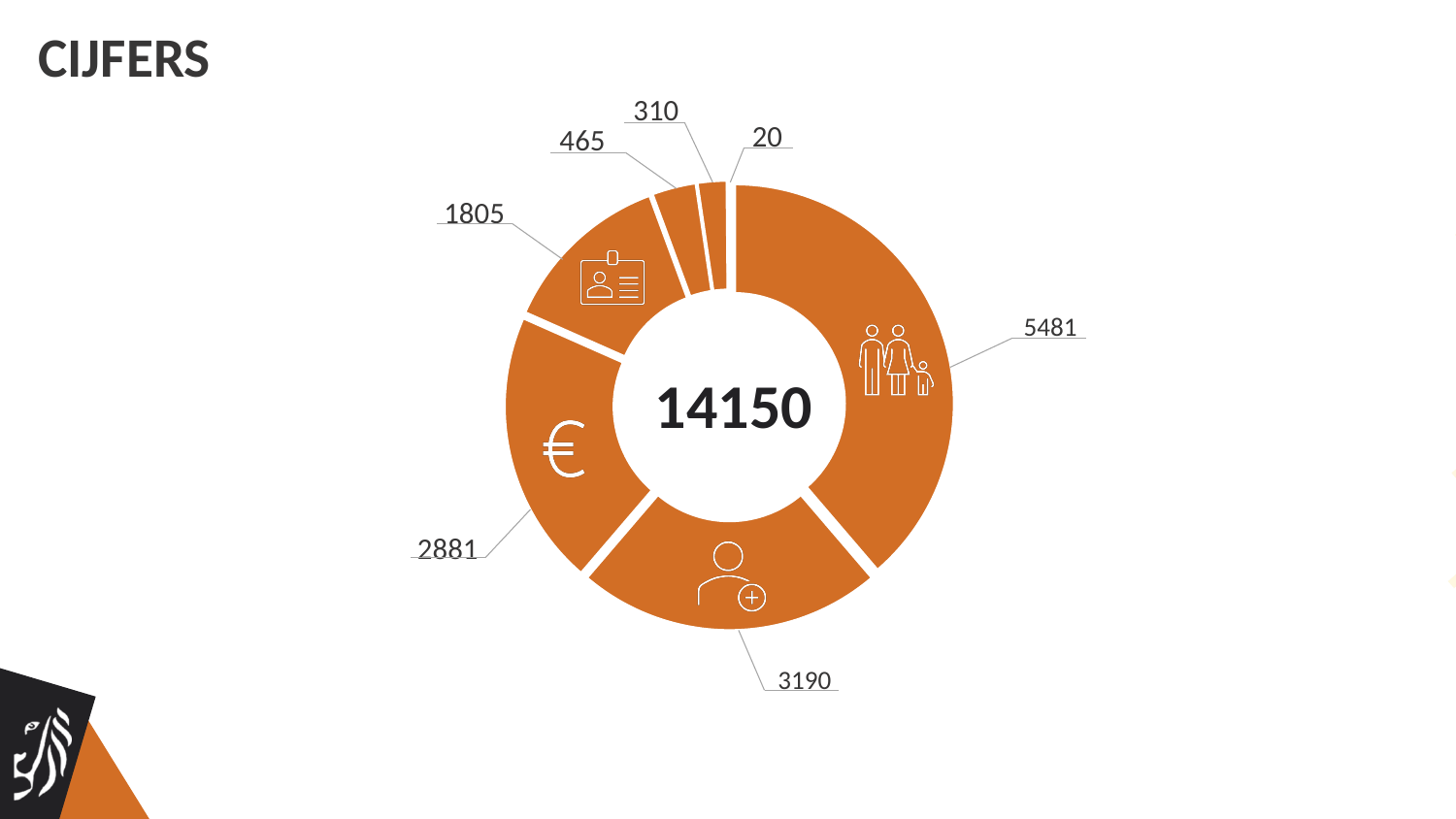
What is the value of the slice marked with the euro (€) symbol? 2881 What is the difference between the slice labelled 5481 and the slice labelled 3190? 2291 What is the value of the smallest slice in the donut chart? 20 Which slice is larger: the one labelled 465 or the one labelled 310? 465 What is the value of the largest slice in the donut chart? 5481 What is the value of the slice marked with the family icon? 5481 How many slices does the donut chart have? 7 What is the value of the slice marked with the person-and-plus icon at the bottom of the chart? 3190 What number is displayed in the centre of the donut chart? 14150 What is the title of the slide containing the chart? CIJFERS What type of chart is shown on the slide? donut (pie) chart What is the value of the slice marked with the ID card icon? 1805